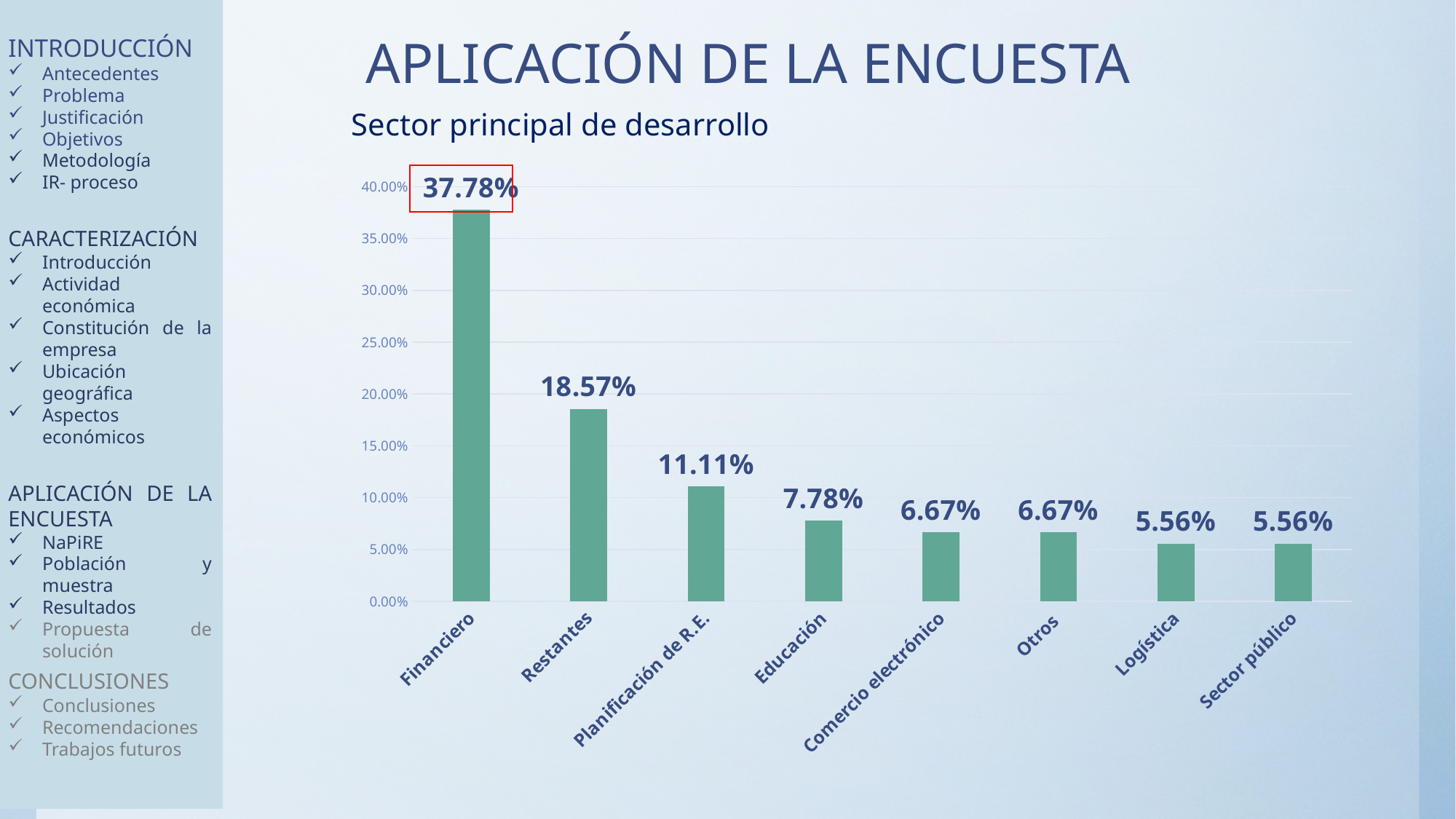
Do the values rise or fall from left to right along the x axis? Fall What is the difference between the values for Financiero and Restantes? 19.21% Which category has the highest value? Financiero What is the value for Planificación de R.E.? 11.11% What is the value for Educación? 7.78% What is the value for Financiero? 37.78% What is the value for Restantes? 18.57% How many categories are shown on the x axis? 8 Which is larger, the value for Educación or the value for Otros? Educación What kind of chart is shown on the slide? Bar chart What is the title of the chart? Sector principal de desarrollo Is the value for Restantes greater or less than 15.00%? greater